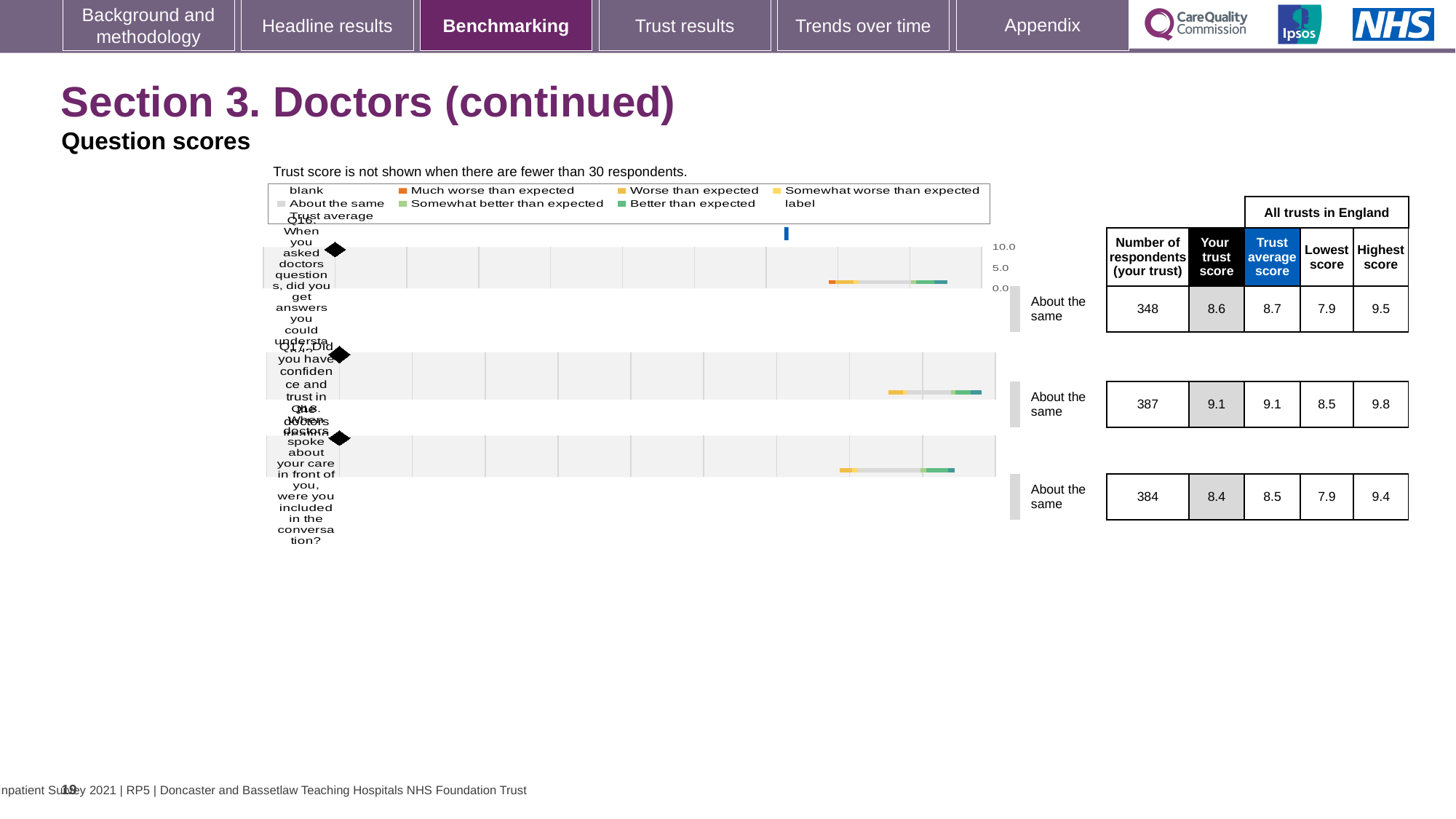
What is the 'Highest score' across all trusts in England for Q17? 9.8 What is the difference between the 'Your trust score' for Q17 and for Q16? 0.5 What benchmark category label is shown next to all three questions in the chart? About the same How many questions are plotted in the question scores chart? 3 Which question has the highest 'Your trust score'? Q17 What is the 'Trust average score' for Q18 (When doctors spoke about your care in front of you, were you included in the conversation)? 8.5 What kind of chart is used to show the question scores on this slide? bar chart How many respondents (your trust) are shown for Q17 (Did you have confidence and trust in the doctors treating you)? 387 What is the 'Your trust score' value for Q16 (When you asked doctors questions, did you get answers you could understand)? 8.6 Which question has the lowest 'Your trust score'? Q18 Which has the larger 'Your trust score', Q16 or Q18? Q16